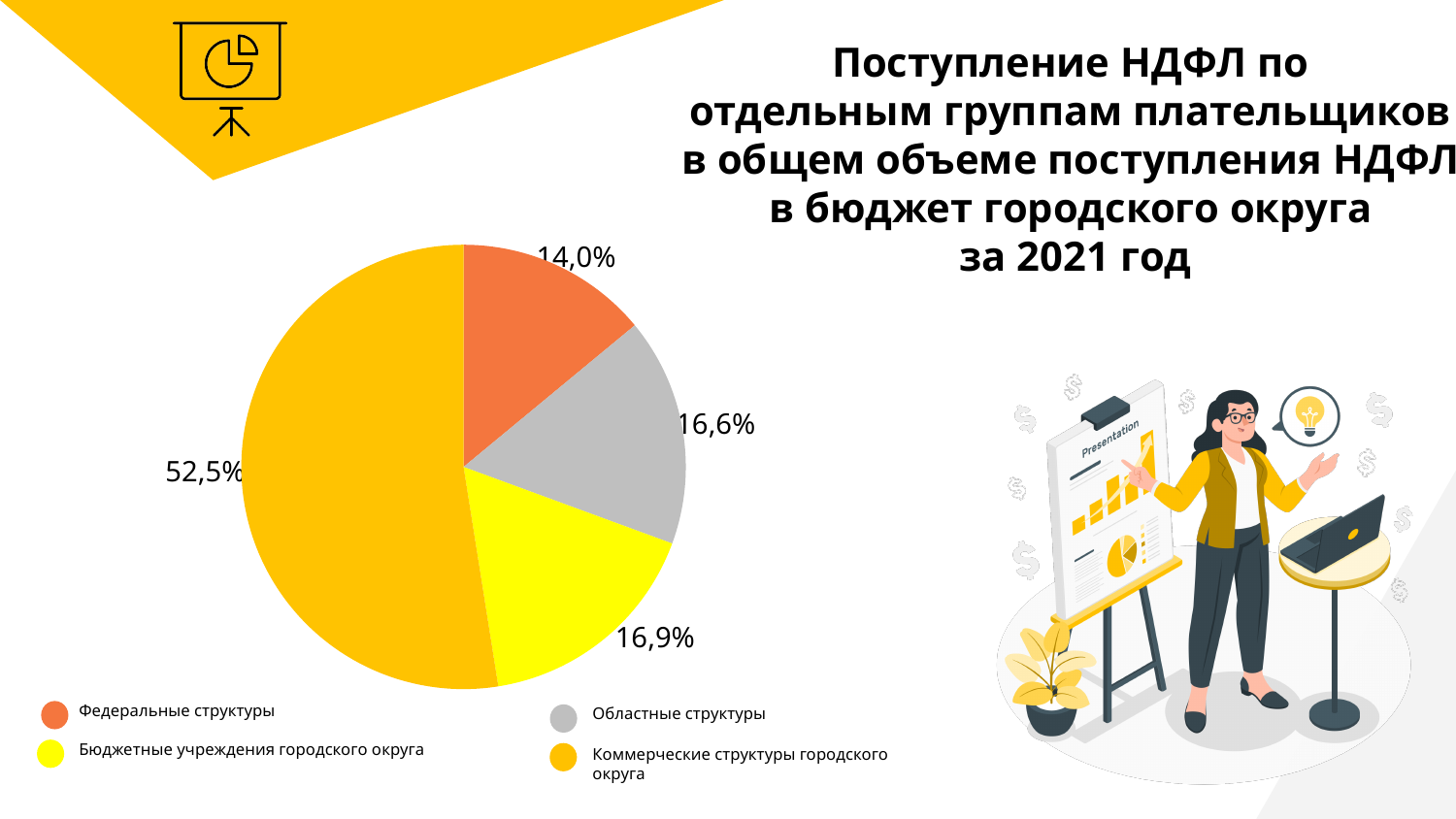
What colour is the slice for Областные структуры in the pie chart? Gray What is the difference in percentage points between the slices for Коммерческие структуры городского округа and Федеральные структуры? 38,5% Which category has the smallest slice of the pie chart? Федеральные структуры What share of the pie chart is labelled for Областные структуры? 16,6% What type of chart is shown on the slide? Pie chart How many entries does the legend of the pie chart list? 4 How many slices does the pie chart have? 4 What share of the pie chart is labelled for Коммерческие структуры городского округа? 52,5% What share of the pie chart is labelled for Федеральные структуры? 14,0% Which category has the largest slice of the pie chart? Коммерческие структуры городского округа What share of the pie chart is labelled for Бюджетные учреждения городского округа? 16,9% Which slice is larger: Бюджетные учреждения городского округа or Областные структуры? Бюджетные учреждения городского округа